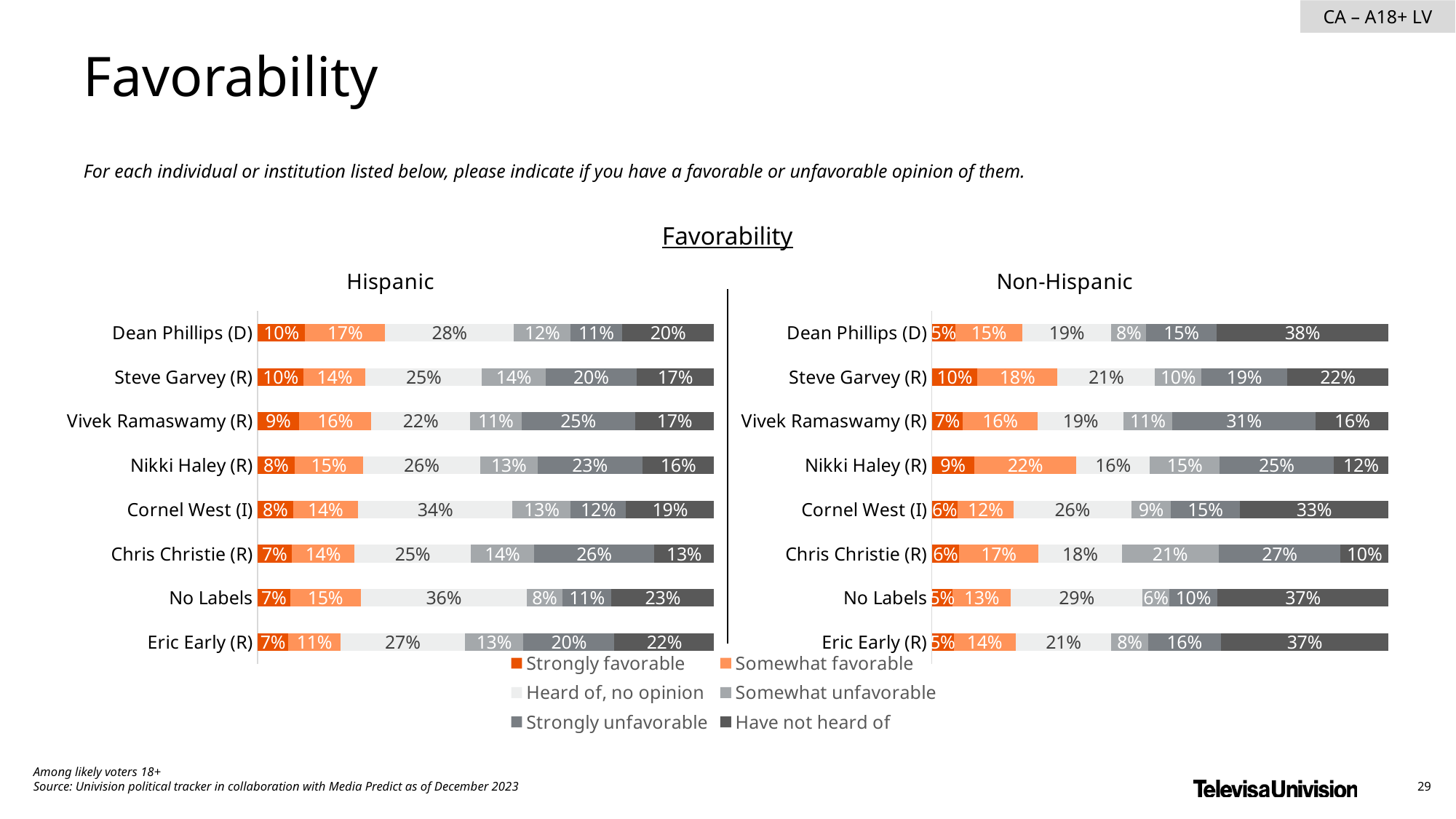
In the Non-Hispanic chart, what is the 'Somewhat favorable' value for Nikki Haley (R)? 22% In the Hispanic chart, what is the 'Heard of, no opinion' value for No Labels? 36% How many individuals or institutions are listed in the Non-Hispanic chart? 8 What type of chart is used for the Hispanic favorability data? Stacked bar chart In the Non-Hispanic chart, what is the difference between the 'Strongly unfavorable' values for Vivek Ramaswamy (R) and Chris Christie (R)? 4% In the Non-Hispanic chart, which individual or institution has the highest 'Have not heard of' value? Dean Phillips (D) In the Hispanic chart, which is larger: the 'Strongly unfavorable' value for Chris Christie (R) or for Cornel West (I)? Chris Christie (R) In the Non-Hispanic chart, what is the combined 'Strongly favorable' and 'Somewhat favorable' value for Steve Garvey (R)? 28% Which legend entry is shown in the darkest orange colour? Strongly favorable How many series does the legend list? 6 In the Hispanic chart, which individual or institution has the lowest 'Have not heard of' value? Chris Christie (R) In the Hispanic chart, what percentage of respondents have not heard of Dean Phillips (D)? 20%